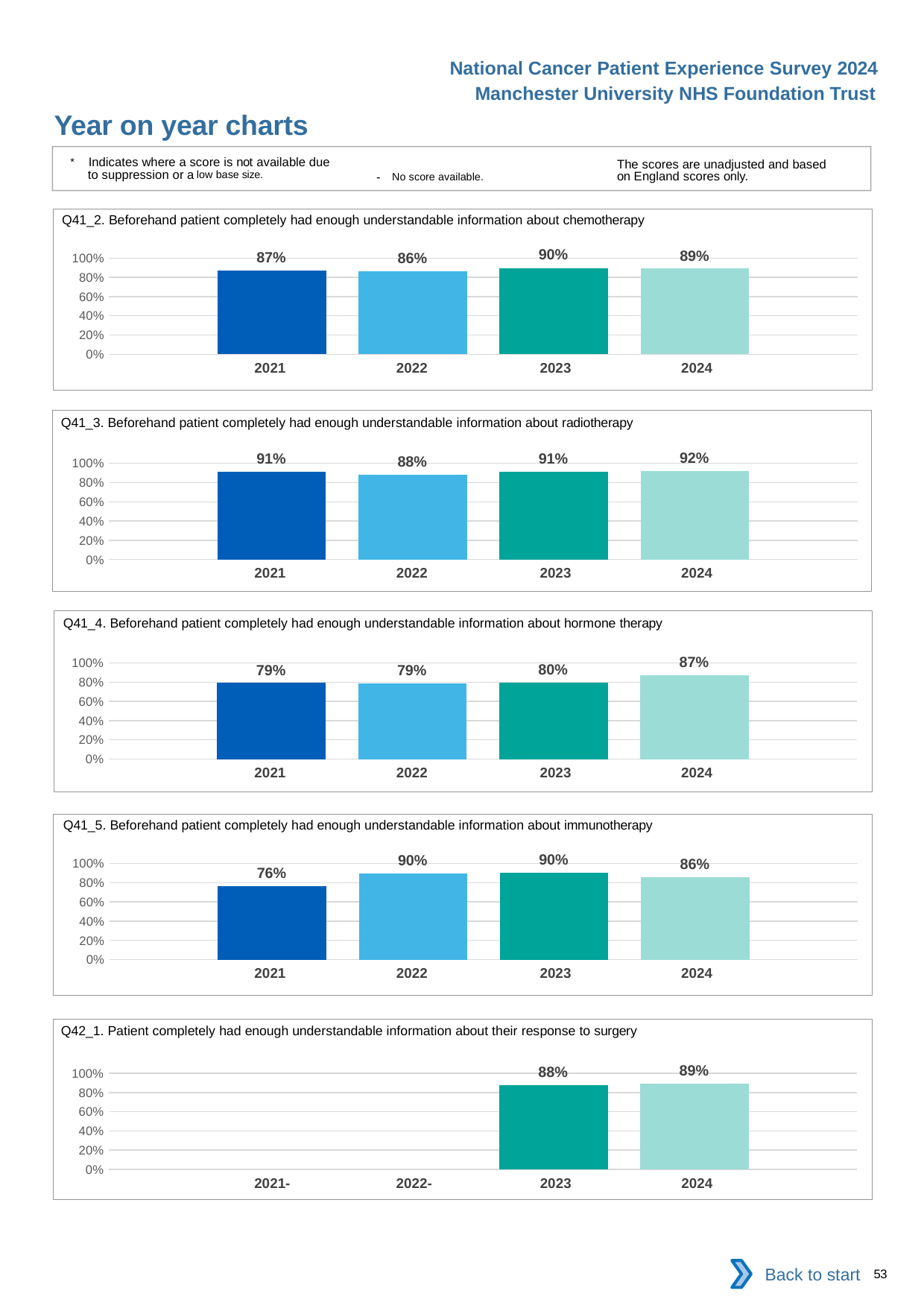
In the Q42_1 response to surgery chart, how many years have a bar plotted? 2 In the Q41_4 hormone therapy chart, which year has the highest value? 2024 In the Q41_5 immunotherapy chart, what is the difference between the 2023 and 2021 values? 14% In the Q41_2 chemotherapy chart, what is the value for 2023? 90% In the Q41_3 radiotherapy chart, what is the value for 2024? 92% In the Q41_5 immunotherapy chart, is the value for 2022 larger or smaller than the value for 2024? larger In the Q42_1 response to surgery chart, what is the value for 2023? 88% In the Q41_2 chemotherapy chart, which year has the lowest value? 2022 In the Q41_4 hormone therapy chart, what is the value for 2021? 79% In the Q41_5 immunotherapy chart, what is the value for 2021? 76% In the Q41_3 radiotherapy chart, what is the difference between the 2024 and 2022 values? 4% What type of chart is the Q41_2 chemotherapy chart? Bar chart